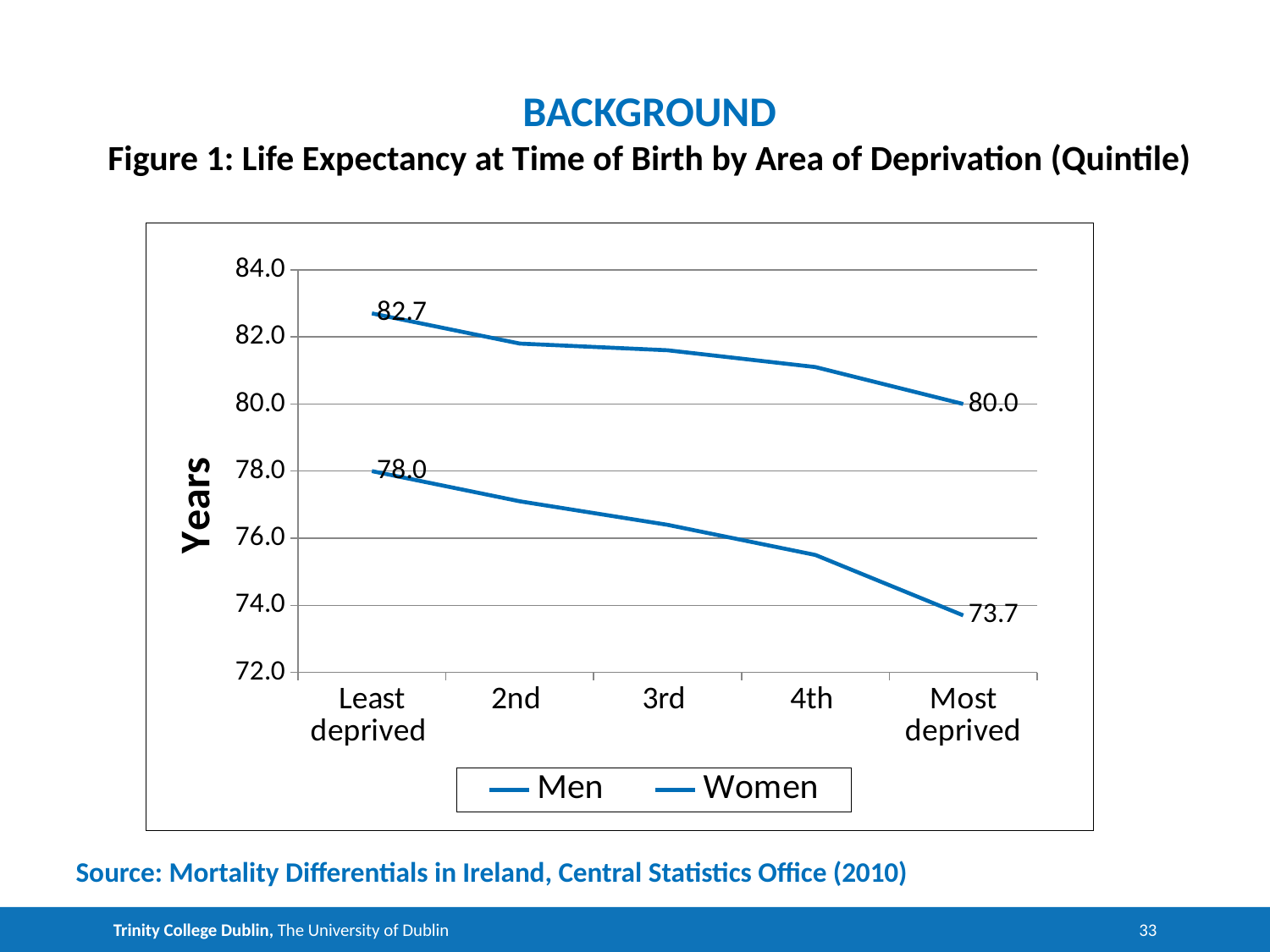
What is the value of the lower line at the Most deprived quintile? 73.7 By how much does the upper line fall from the Least deprived to the Most deprived quintile? 2.7 What kind of chart is shown on the slide? line chart By how much does the lower line fall from the Least deprived to the Most deprived quintile? 4.3 Is the value of the lower line at the 4th quintile greater or less than 76.0? less What is the value of the lower line at the Least deprived quintile? 78.0 What is the difference between the two lines at the Most deprived quintile? 6.3 What is the value of the upper line at the Least deprived quintile? 82.7 How many series does the legend list? 2 Do the values rise or fall as you move from Least deprived to Most deprived? fall How many deprivation categories are shown along the x axis? 5 What is the value of the upper line at the Most deprived quintile? 80.0